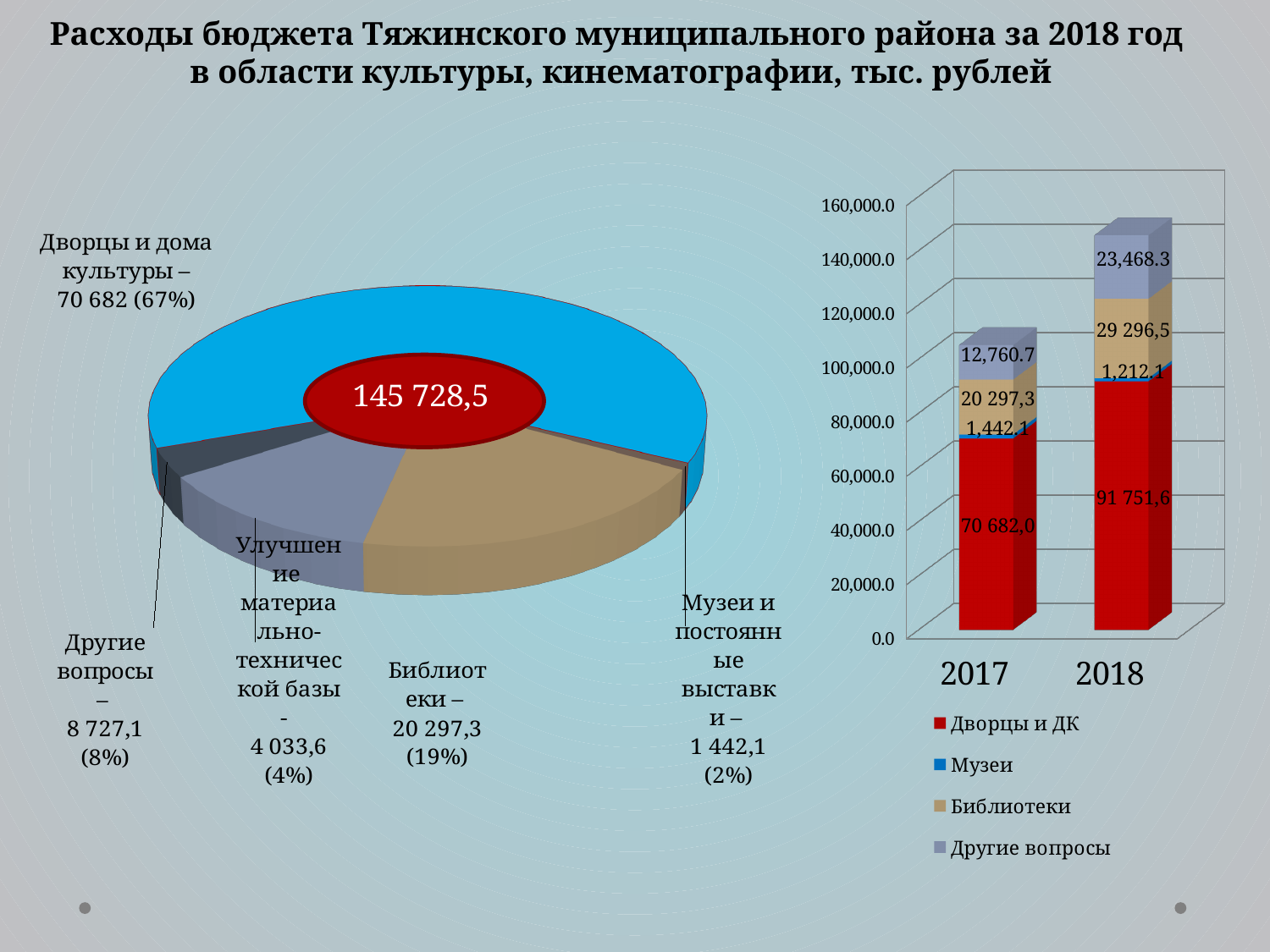
In the bar chart on the right, what is the value for Дворцы и ДК in 2018? 91 751,6 In the pie chart on the left, what value is shown for Библиотеки? 20 297,3 In the pie chart on the left, what total value is printed in the centre of the pie? 145 728,5 In the pie chart on the left, what share of the pie does Дворцы и дома культуры have? 67% In the bar chart on the right, does the value for Библиотеки rise or fall from 2017 to 2018? rise In the bar chart on the right, how many series does the legend list? 4 In the bar chart on the right, what is the value for Другие вопросы in 2017? 12,760.7 In the pie chart on the left, which category has the smallest slice? Музеи и постоянные выставки In the pie chart on the left, which is larger: Другие вопросы or Улучшение материально-технической базы? Другие вопросы What kind of chart is on the right side of the slide? Stacked bar chart In the pie chart on the left, how many slices are there? 5 In the bar chart on the right, is the total for 2018 greater or less than 140,000.0? greater